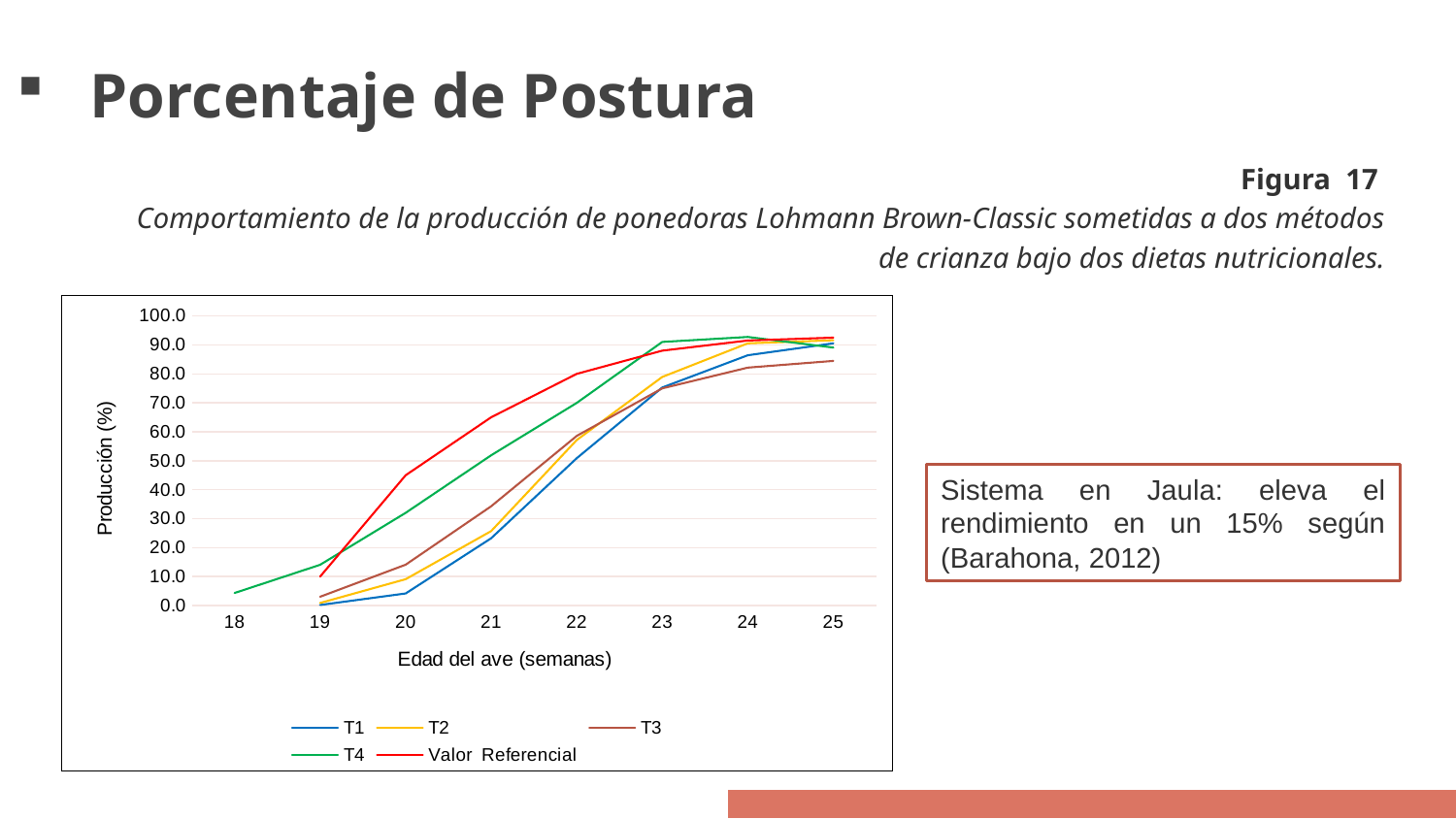
Does the T1 line rise or fall as the age of the bird increases from week 19 to week 25? rise What is the title of the y axis? Producción (%) Is the value for T3 at week 25 greater or less than 90.0? less What kind of chart is shown on the slide? line chart How many age values (weeks) are shown on the x axis? 8 How many series does the legend list? 5 Is the value for T1 at week 20 greater or less than 10.0? less Which series has the lowest value at week 25? T3 Is the value for Valor Referencial at week 20 greater or less than 40.0? greater What is the title of the x axis? Edad del ave (semanas) Which series has the highest value at week 21? Valor Referencial At week 21, which is larger: the value for Valor Referencial or the value for T1? Valor Referencial